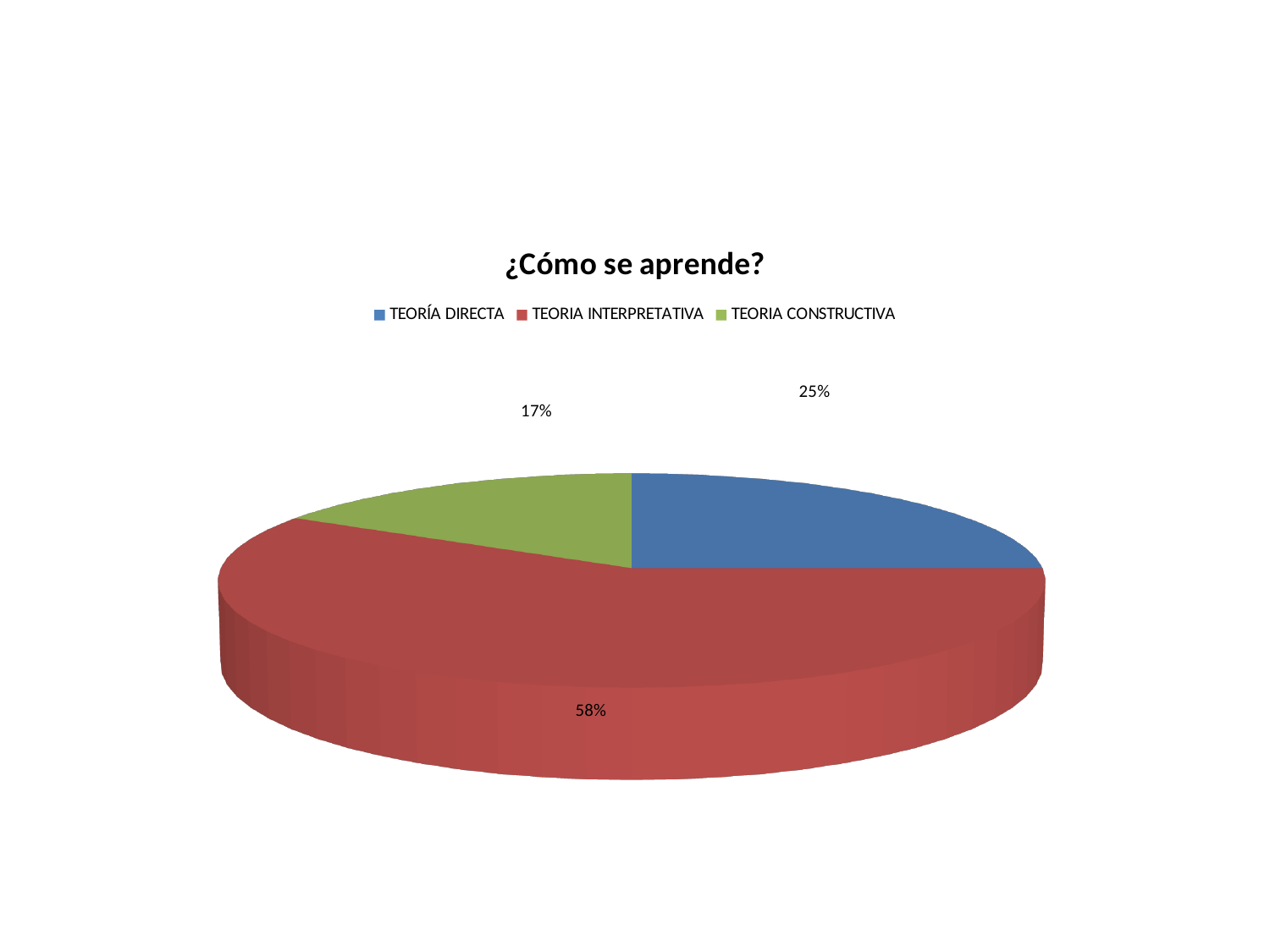
Which is larger, the share for TEORÍA DIRECTA or the share for TEORIA CONSTRUCTIVA? TEORÍA DIRECTA What share of the pie does TEORÍA DIRECTA represent? 25% What kind of chart is shown on the slide? Pie chart What is the difference between the shares of TEORÍA DIRECTA and TEORIA CONSTRUCTIVA? 8% Which category has the smallest slice of the pie? TEORIA CONSTRUCTIVA Which colour represents TEORIA CONSTRUCTIVA in the chart? Green What share of the pie does TEORIA INTERPRETATIVA represent? 58% What share of the pie does TEORIA CONSTRUCTIVA represent? 17% What is the title of the chart? ¿Cómo se aprende? How many categories are shown in the pie chart? 3 What is the difference between the shares of TEORIA INTERPRETATIVA and TEORÍA DIRECTA? 33% Which category has the largest slice of the pie? TEORIA INTERPRETATIVA